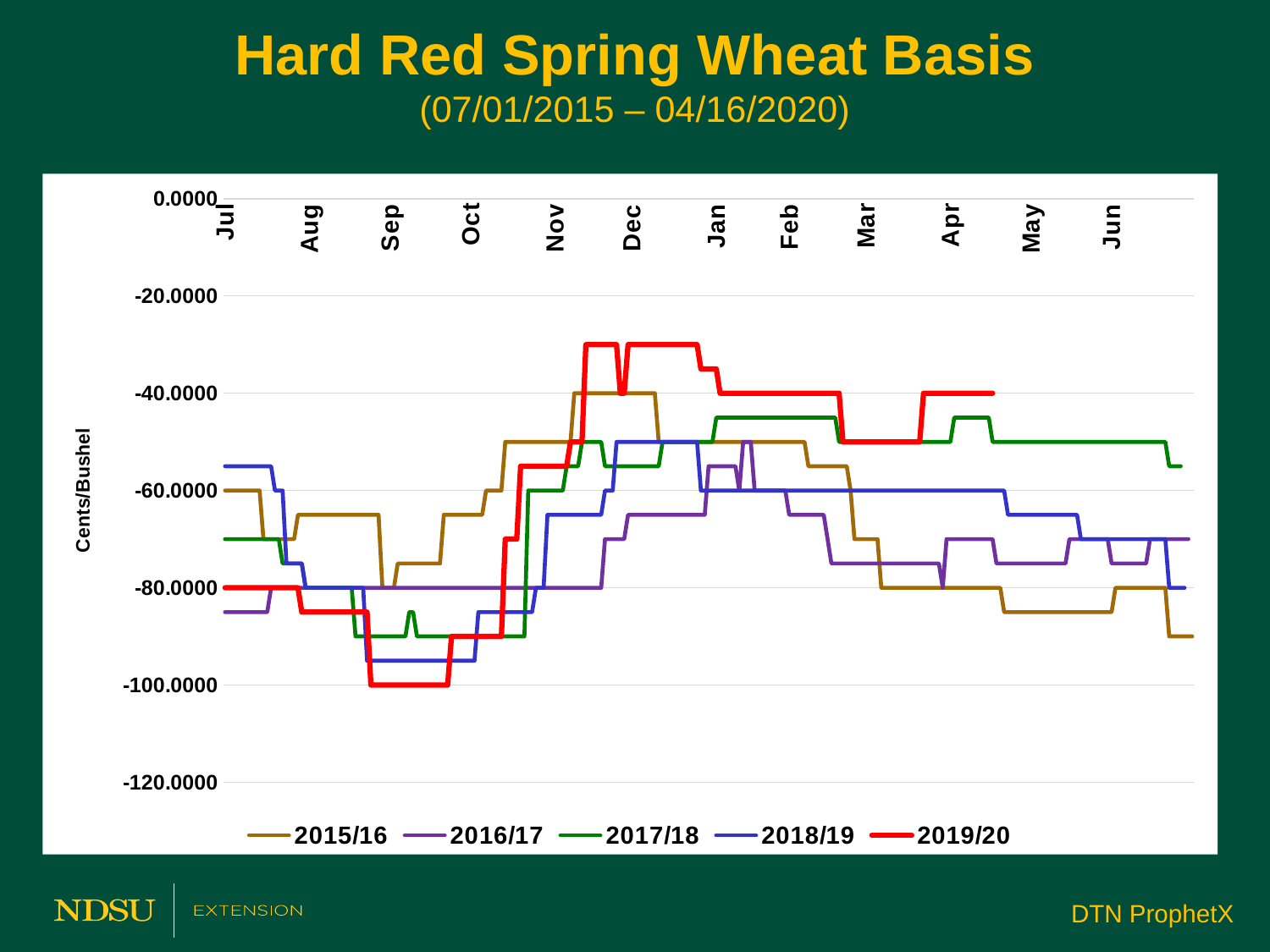
Which series has the highest value in Dec? 2019/20 Is the value for 2017/18 in May greater or less than -60? greater What kind of chart is shown on the slide? line chart What is the label on the y axis? Cents/Bushel Is the value for 2017/18 in Sep greater or less than -80? less How many series does the legend list? 5 Which series has the lowest value in Sep? 2019/20 How many months are labelled along the x axis? 12 Is the value for 2019/20 in Dec greater or less than -40? greater In Nov, which series has the larger value, 2019/20 or 2016/17? 2019/20 What is the title of the chart? Hard Red Spring Wheat Basis